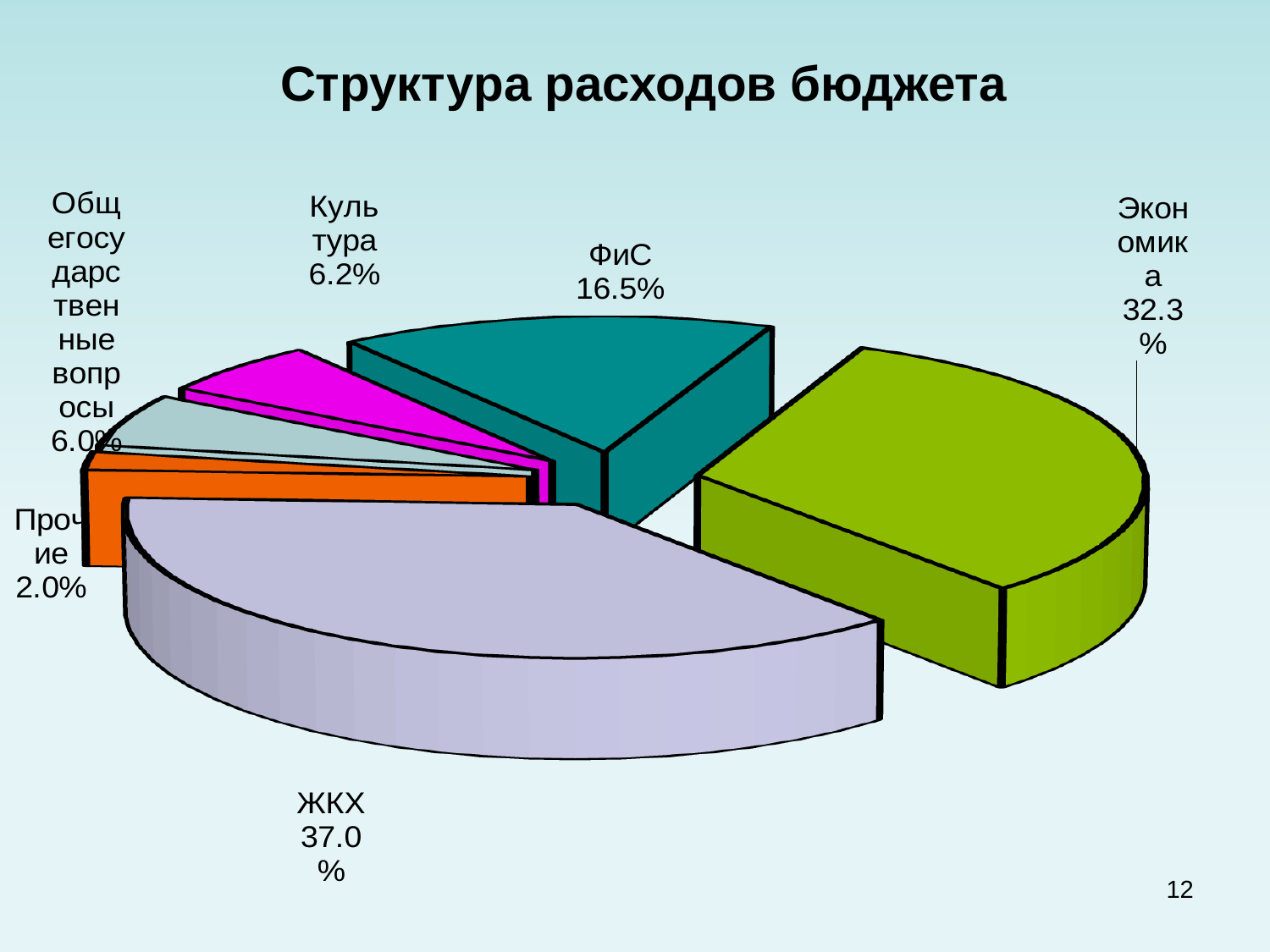
What kind of chart is shown on the slide? Pie chart What share of the budget expenditure goes to Культура? 6.2% Which is larger, the share for ФиС or the share for Культура? ФиС How many categories are shown in the pie chart? 6 Which category has the smallest share of budget expenditure? Прочие What share of the budget expenditure goes to Экономика? 32.3% What is the title of the chart? Структура расходов бюджета What share of the budget expenditure goes to ФиС? 16.5% What is the difference in percentage points between ЖКХ and Экономика? 4.7 What share of the budget expenditure goes to Прочие? 2.0% Which category has the largest share of budget expenditure? ЖКХ What share of the budget expenditure goes to ЖКХ? 37.0%